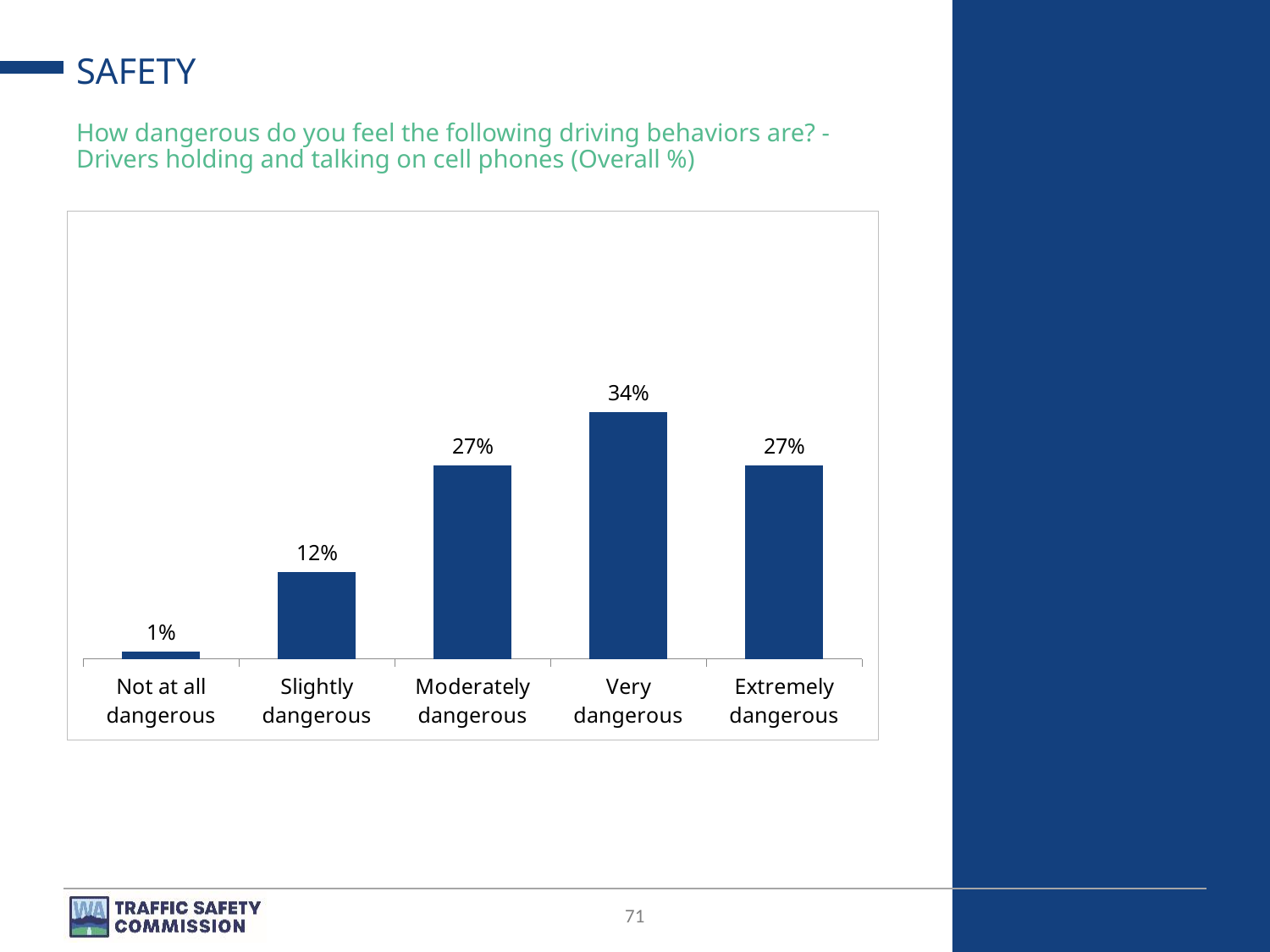
What percentage of respondents chose "Extremely dangerous"? 27% What percentage of respondents chose "Slightly dangerous"? 12% Which response category has the lowest percentage? Not at all dangerous What driving behavior does the chart on this slide ask about? Drivers holding and talking on cell phones How many response categories are shown on the chart? 5 What type of chart is shown on the slide? Bar chart What percentage of respondents rated drivers holding and talking on cell phones as "Not at all dangerous"? 1% Which response category has the highest percentage? Very dangerous What is the difference in percentage points between "Slightly dangerous" and "Not at all dangerous"? 11 What is the difference in percentage points between "Very dangerous" and "Moderately dangerous"? 7 What percentage of respondents rated drivers holding and talking on cell phones as "Very dangerous"? 34% Which is larger, the percentage for "Slightly dangerous" or for "Extremely dangerous"? Extremely dangerous